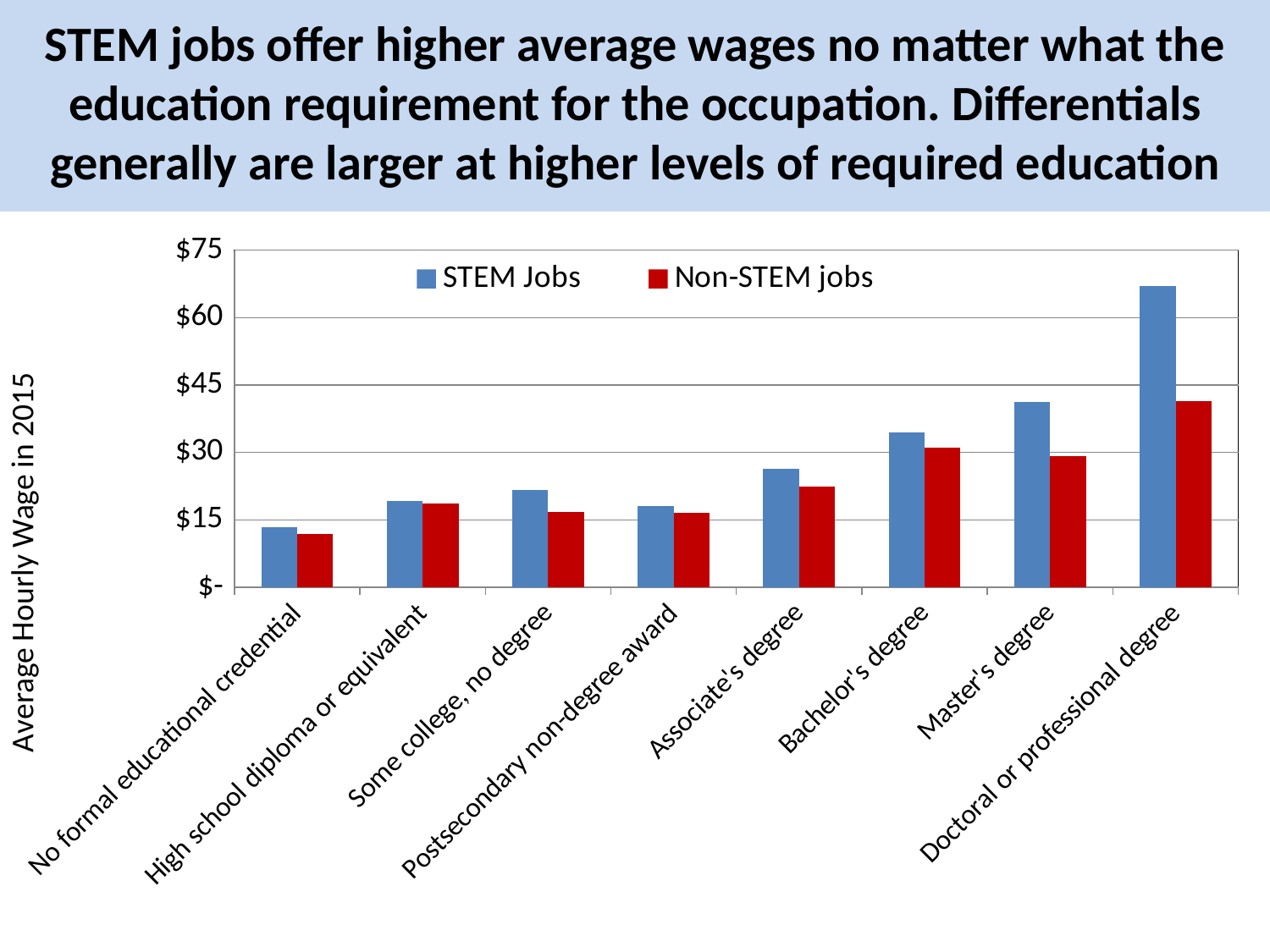
Do the STEM Jobs values generally rise or fall from left to right across the education categories? rise For Master's degree, which is larger: the STEM Jobs value or the Non-STEM jobs value? STEM Jobs Is the STEM Jobs value for Doctoral or professional degree greater or less than $60? greater What kind of chart is shown on the slide? Bar chart Is the STEM Jobs value for Associate's degree greater or less than $30? less How many education categories are shown on the x axis? 8 Which education category has the lowest Non-STEM jobs average hourly wage? No formal educational credential Which education category has the highest STEM Jobs average hourly wage? Doctoral or professional degree What is the title of the vertical axis? Average Hourly Wage in 2015 How many series does the legend list? 2 Is the Non-STEM jobs value for No formal educational credential greater or less than $15? less